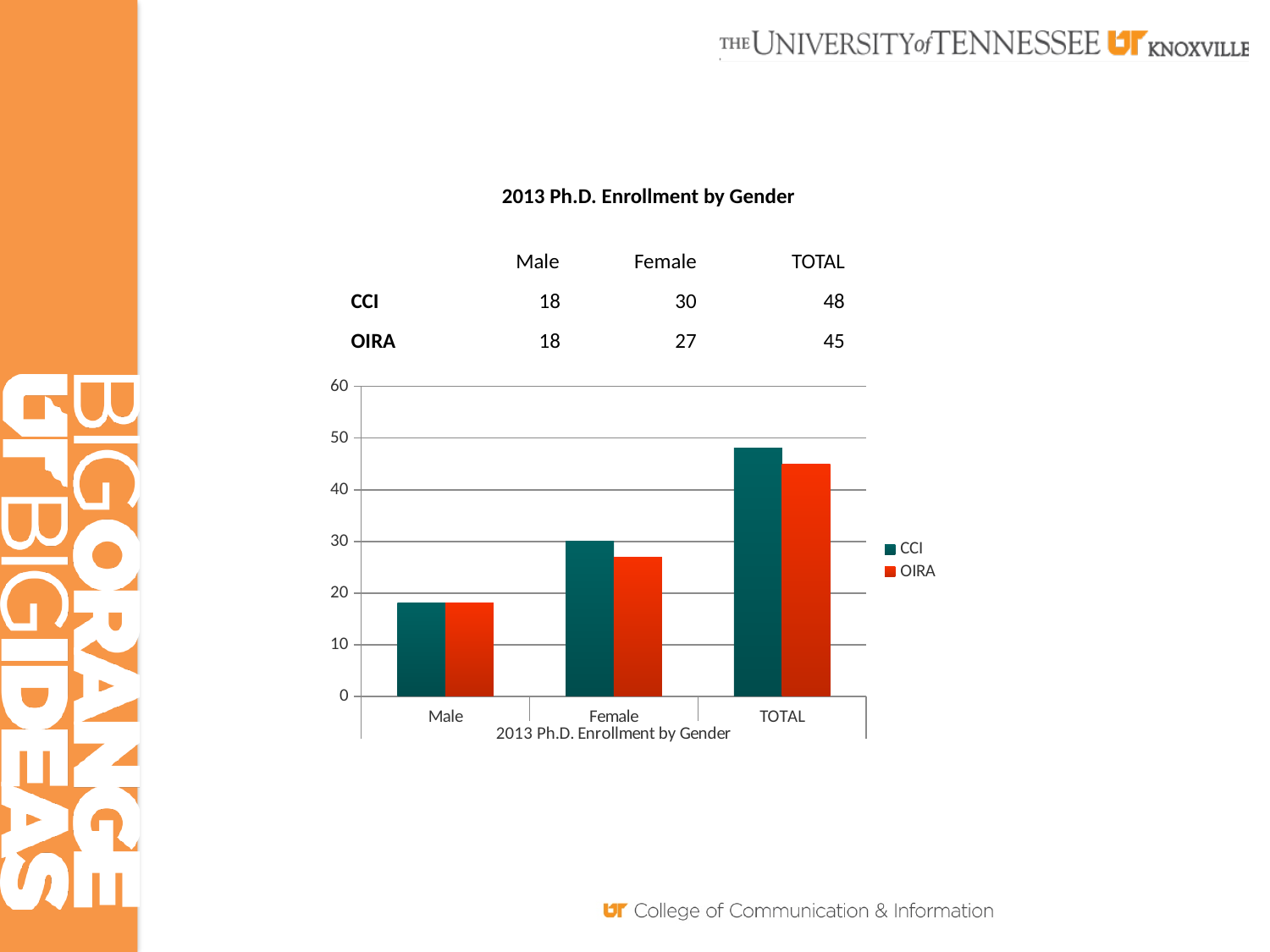
How many categories are shown on the x axis of the chart? 3 What is the OIRA value for Male? 18 Which category has the lowest OIRA value? Male What is the CCI value for Female? 30 What is the OIRA value for Female? 27 What is the difference between the CCI and OIRA values for TOTAL? 3 What is the title of the chart? 2013 Ph.D. Enrollment by Gender What kind of chart is shown on the slide? bar chart What is the CCI value for TOTAL? 48 For Female, which series has the larger value, CCI or OIRA? CCI How many series does the chart legend list? 2 Which category has the highest CCI value? TOTAL